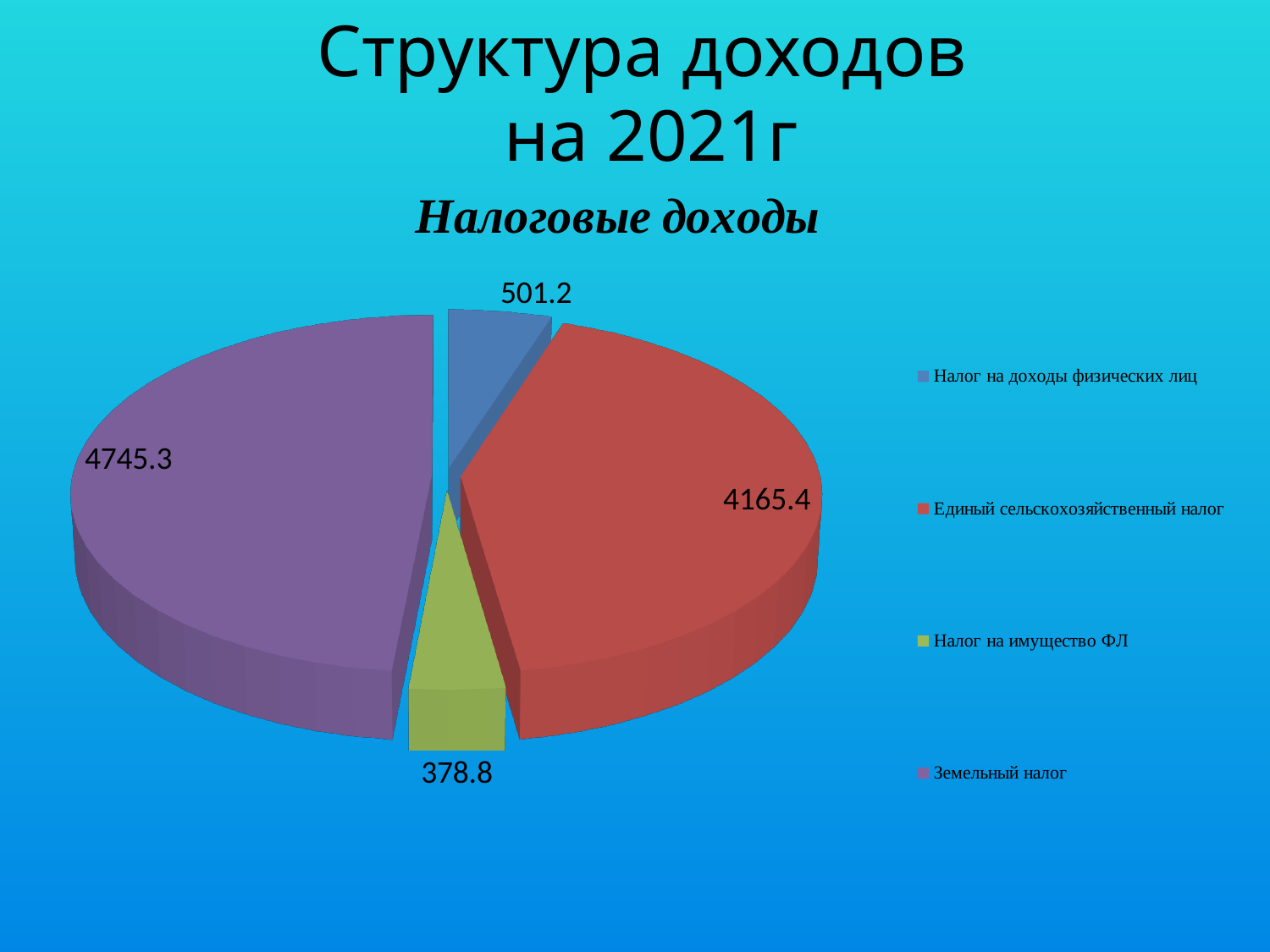
What is the total of all the slices in the pie chart? 9790.7 What is the difference between the values for Земельный налог and Единый сельскохозяйственный налог? 579.9 What is the title of the chart? Налоговые доходы What is the value for Земельный налог? 4745.3 What is the value for Налог на доходы физических лиц? 501.2 What is the value for Налог на имущество ФЛ? 378.8 What kind of chart is shown on the slide? Pie chart How many categories does the pie chart show? 4 Which category has the smallest slice of the pie? Налог на имущество ФЛ What is the value for Единый сельскохозяйственный налог? 4165.4 Which category has the largest slice of the pie? Земельный налог Which is larger: Налог на доходы физических лиц or Налог на имущество ФЛ? Налог на доходы физических лиц